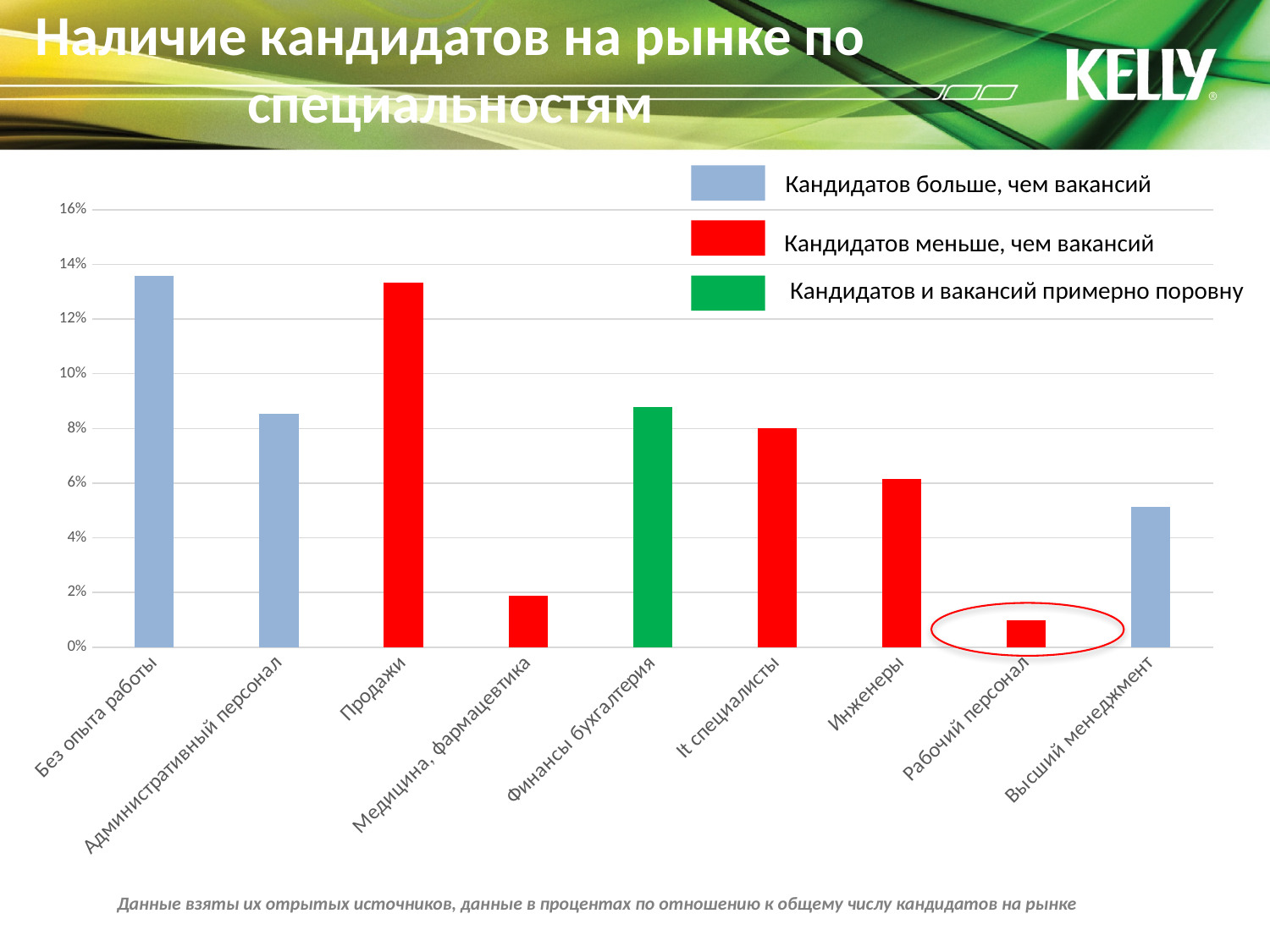
Is the value for Высший менеджмент greater or less than 4%? greater Which is larger, the value for Инженеры or the value for Высший менеджмент? Инженеры What kind of chart is shown on the slide? bar chart Which is larger, the value for Продажи or the value for Инженеры? Продажи Is the value for Без опыта работы greater or less than 12%? greater How many entries does the legend list? 3 Is the value for Инженеры greater or less than 8%? less How many categories (specialties) are shown on the x axis? 9 What colour is the bar for Продажи? red Which category has the lowest value? Рабочий персонал